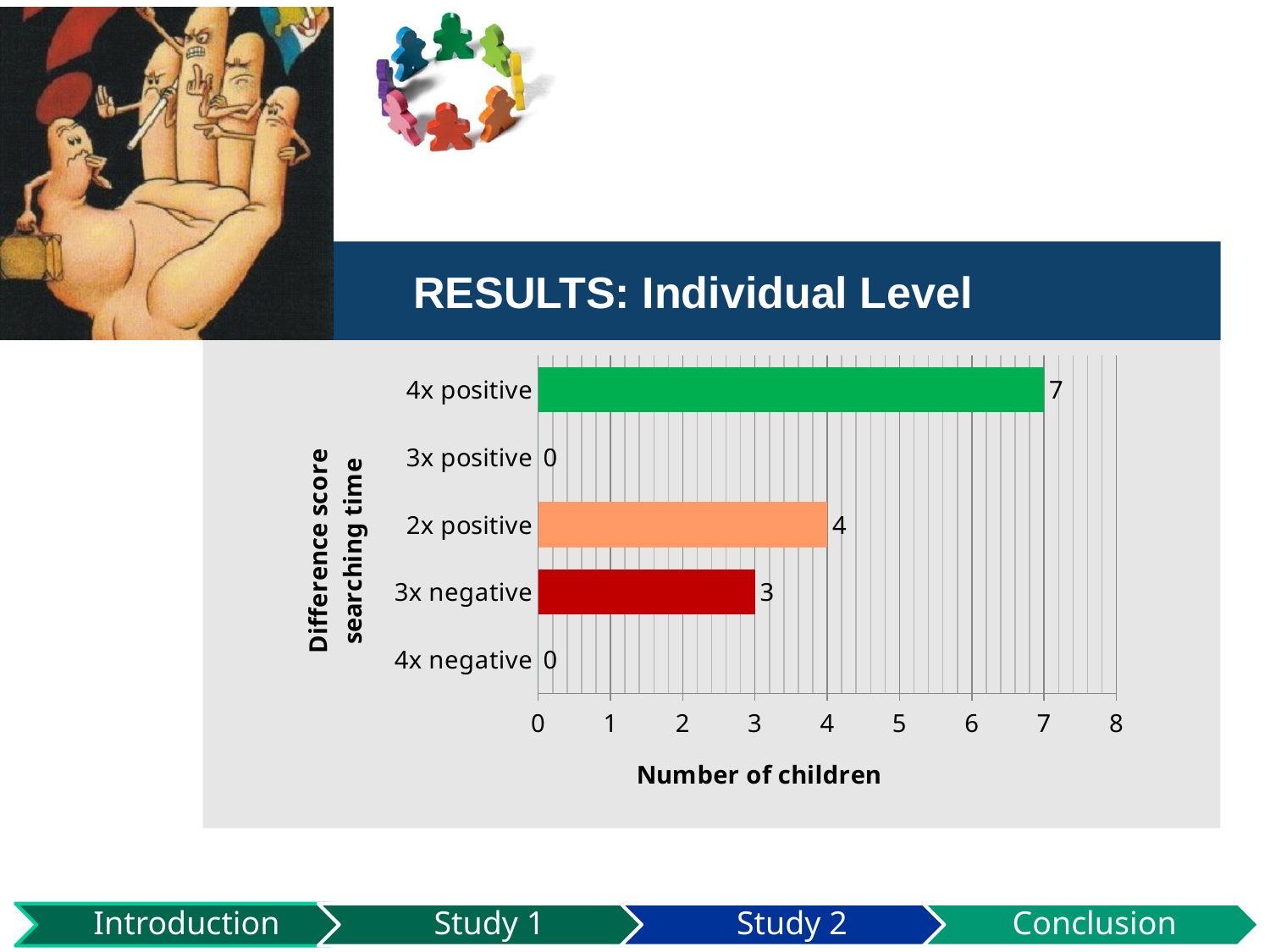
Which category has the highest number of children? 4x positive What is the number of children for the 2x positive category? 4 How many categories are shown on the y axis of the chart? 5 What kind of chart is shown on the slide? Bar chart What is the difference in number of children between 4x positive and 2x positive? 3 What is the label of the x axis of the chart? Number of children Is the value for 4x positive greater or less than 6? greater What is the number of children for the 3x negative category? 3 How many categories have a value of 0? 2 What is the number of children for the 4x positive category? 7 Which has more children, 2x positive or 3x negative? 2x positive What is the number of children for the 3x positive category? 0